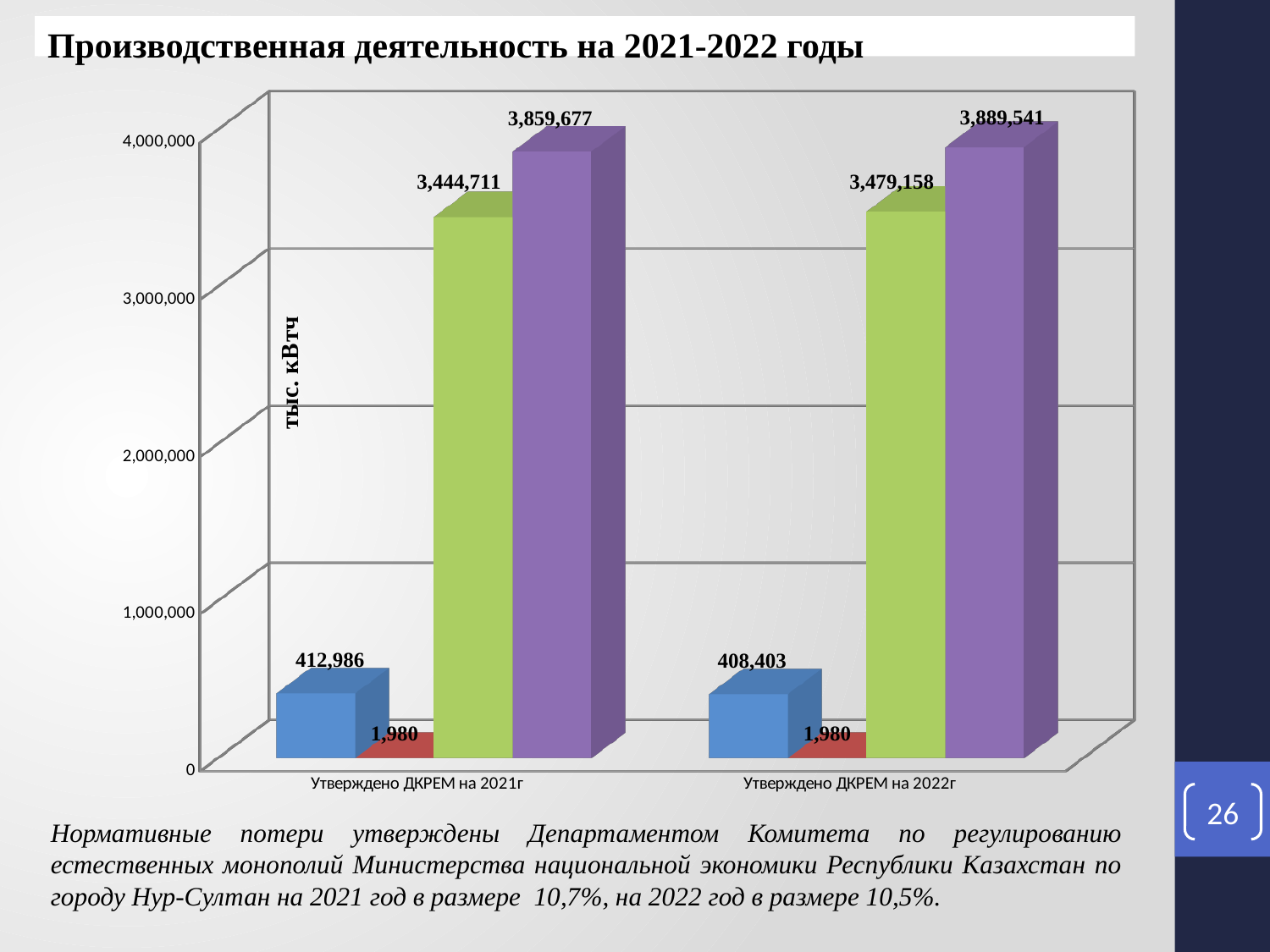
What is the label on the vertical axis of the chart? тыс. кВтч Which bar has the highest value in the chart? the purple bar for Утверждено ДКРЕМ на 2022г (3,889,541) What is the value of the green bar for "Утверждено ДКРЕМ на 2022г"? 3,479,158 What is the value of the red bar for "Утверждено ДКРЕМ на 2022г"? 1,980 How many categories are shown on the x axis of the chart? 2 What is the value of the purple bar for "Утверждено ДКРЕМ на 2021г"? 3,859,677 What is the difference between the purple bar values for 2022 and 2021? 29,864 Which is larger: the green bar for 2021 or the green bar for 2022? the green bar for 2022 (3,479,158) What type of chart is shown on the slide? bar chart What is the difference between the blue bar values for 2021 and 2022? 4,583 Is the value of the blue bar for "Утверждено ДКРЕМ на 2022г" greater or less than 1,000,000? less What is the value of the blue bar for "Утверждено ДКРЕМ на 2021г"? 412,986